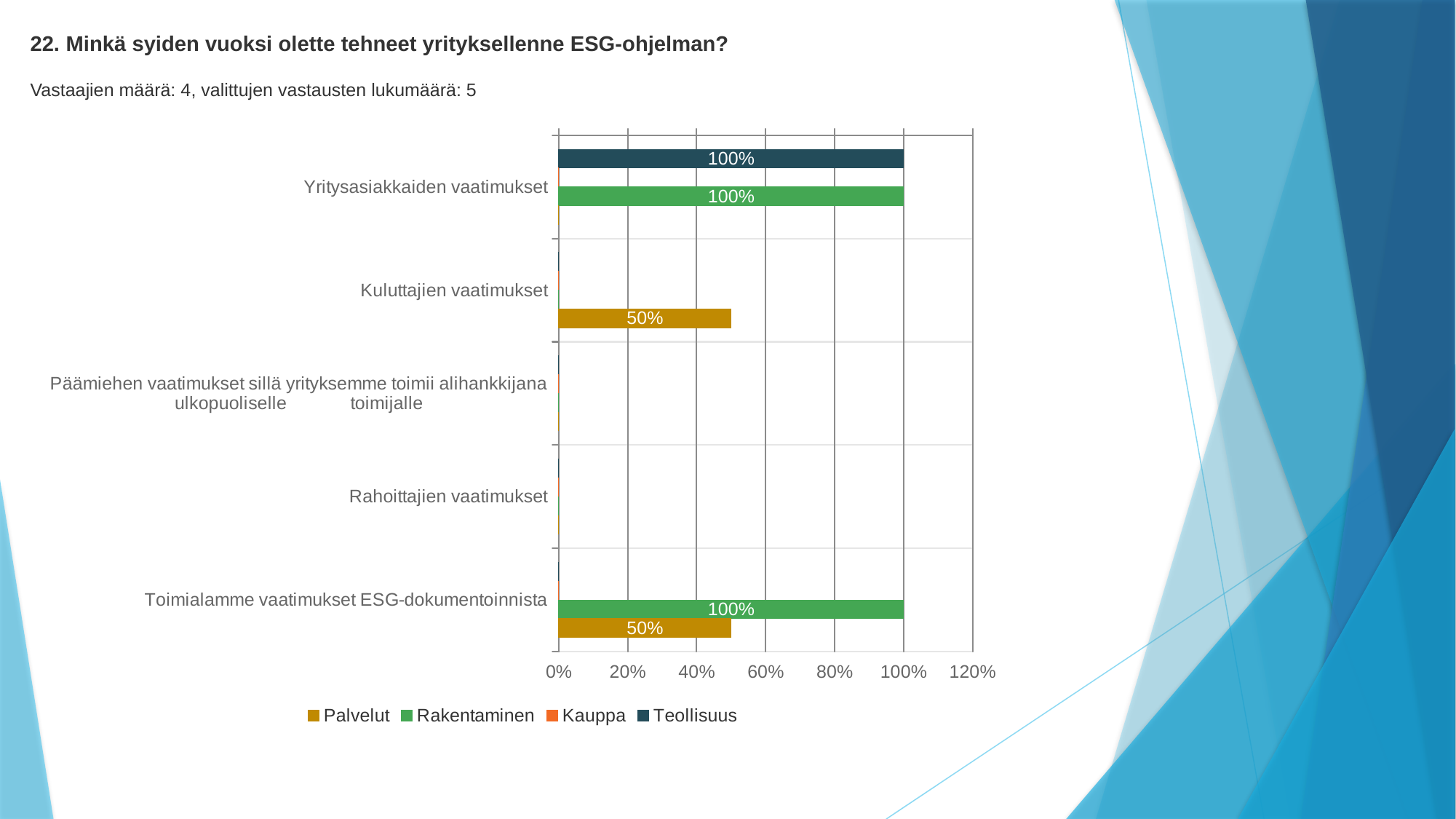
What is the value for Palvelut in the category Kuluttajien vaatimukset? 50% What is the value for Teollisuus in the category Yritysasiakkaiden vaatimukset? 100% What is the value for Rakentaminen in the category Yritysasiakkaiden vaatimukset? 100% How many categories are shown on the vertical axis of the chart? 5 What is the difference between the Rakentaminen and Palvelut values in the category Toimialamme vaatimukset ESG-dokumentoinnista? 50% Is the value for Palvelut in the category Kuluttajien vaatimukset greater or less than 60%? less What is the value for Rakentaminen in the category Toimialamme vaatimukset ESG-dokumentoinnista? 100% How many series does the legend list? 4 In the category Toimialamme vaatimukset ESG-dokumentoinnista, which series has the larger value, Rakentaminen or Palvelut? Rakentaminen Which series is shown in the legend with an orange colour? Kauppa What kind of chart is shown on the slide? Bar chart What is the value for Palvelut in the category Toimialamme vaatimukset ESG-dokumentoinnista? 50%